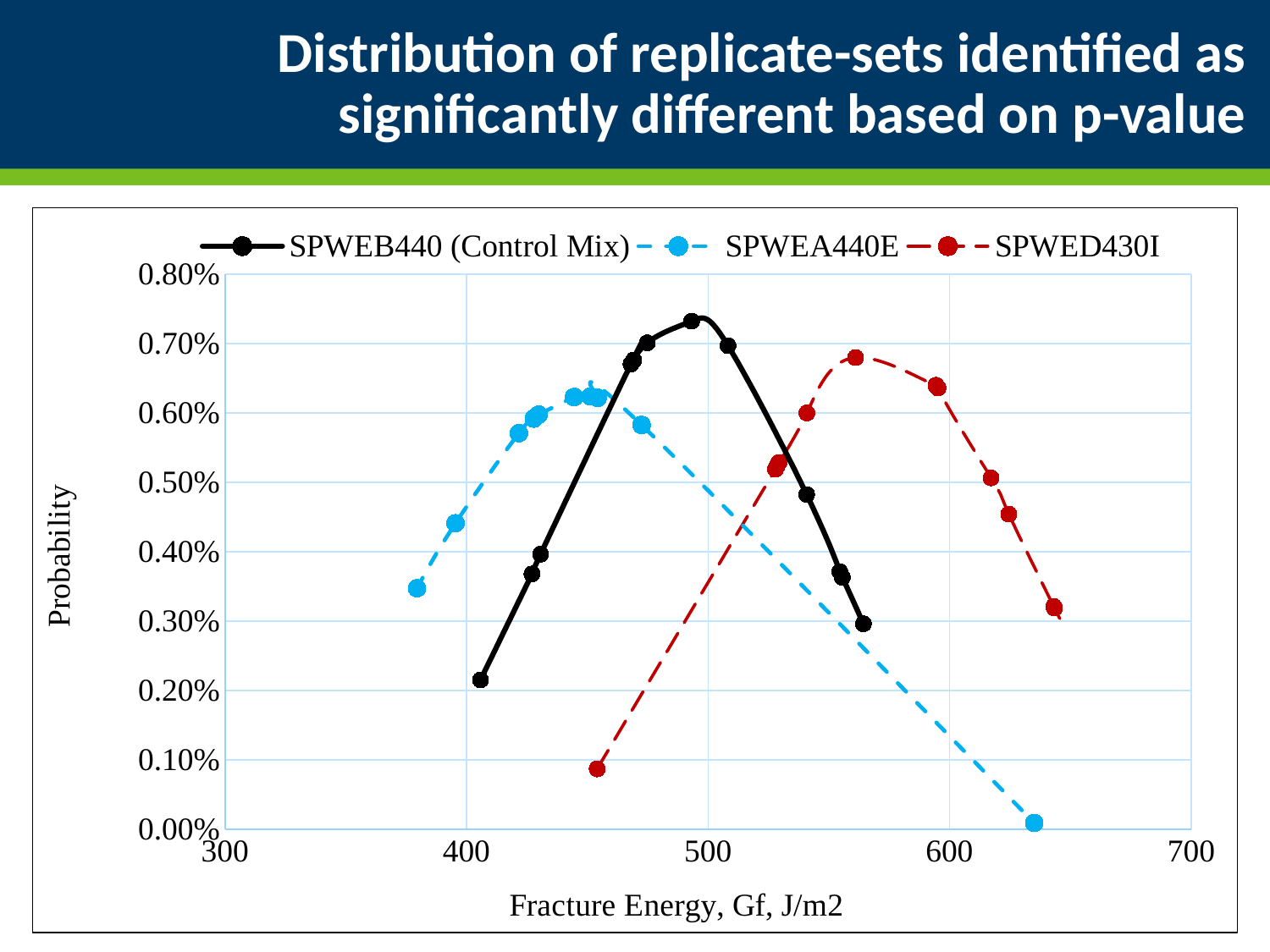
Which series reaches the highest peak probability? SPWEB440 (Control Mix) Is the peak value of SPWEA440E greater or less than 0.70%? less What kind of chart is shown on the slide? line chart How many series does the legend list? 3 Which series peaks at the highest fracture energy along the x axis? SPWED430I What is the label of the x axis? Fracture Energy, Gf, J/m2 Is the peak value of SPWEB440 (Control Mix) greater or less than 0.70%? greater How does the SPWEA440E series change as fracture energy increases from 500 to 650 J/m2? it falls Which series has the lowest peak probability? SPWEA440E Is the peak value of SPWED430I greater or less than 0.60%? greater Which series is drawn with a solid black line? SPWEB440 (Control Mix) Which series peaks at the lowest fracture energy along the x axis? SPWEA440E